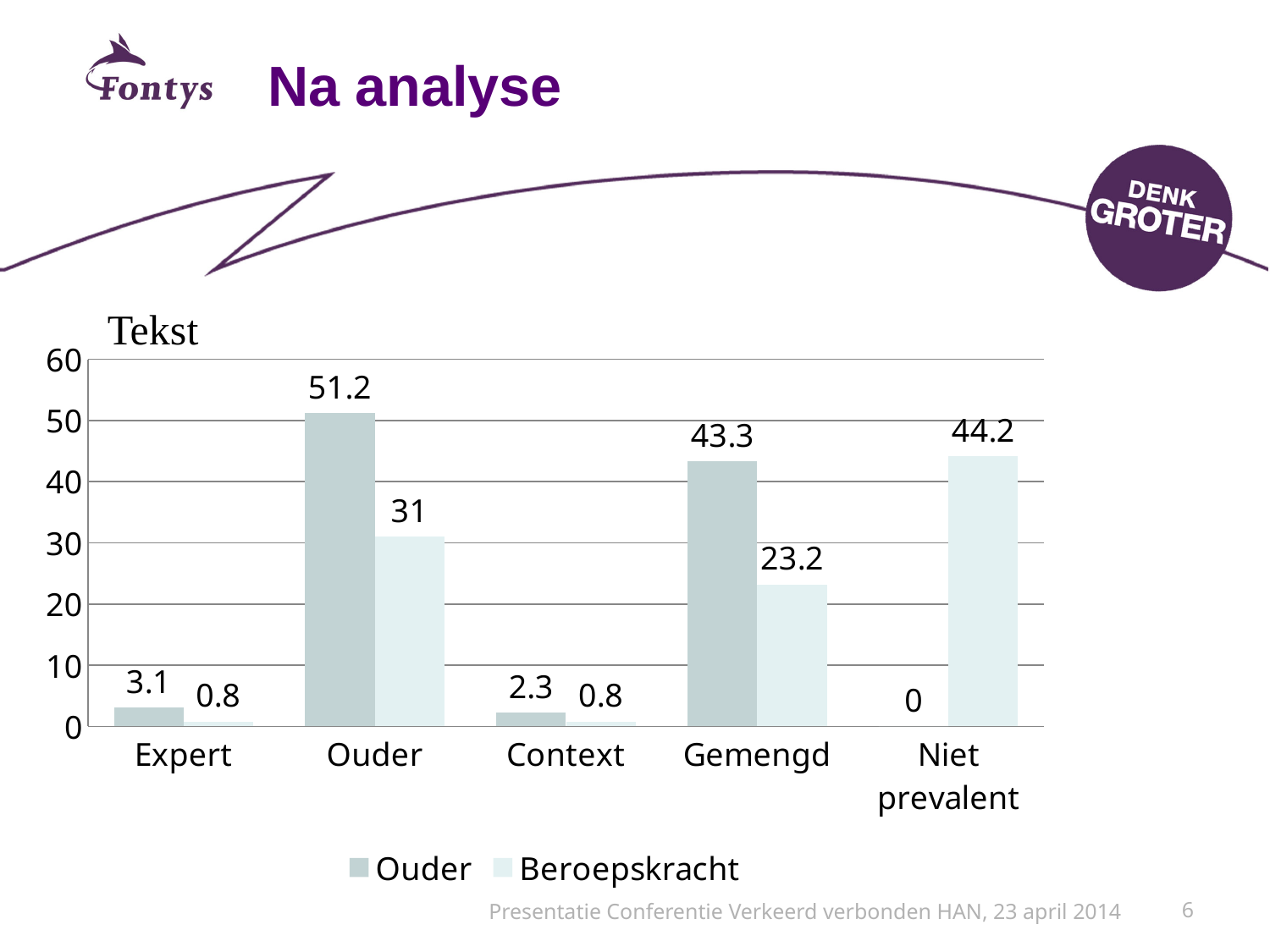
How many series does the legend list? 2 What is the difference between the Ouder and Beroepskracht values for the Ouder category? 20.2 How many categories are shown on the x axis? 5 What is the value for Niet prevalent in the Ouder series? 0 Which category has the highest value in the Beroepskracht series? Niet prevalent What is the value for Gemengd in the Beroepskracht series? 23.2 What is the value for Ouder in the Ouder series? 51.2 Which category has the lowest value in the Ouder series? Niet prevalent Is the Beroepskracht value for Ouder greater or less than 40? less What is the difference between the Ouder and Beroepskracht values for Gemengd? 20.1 Which is larger for Expert: the Ouder value or the Beroepskracht value? Ouder What kind of chart is shown on the slide? bar chart